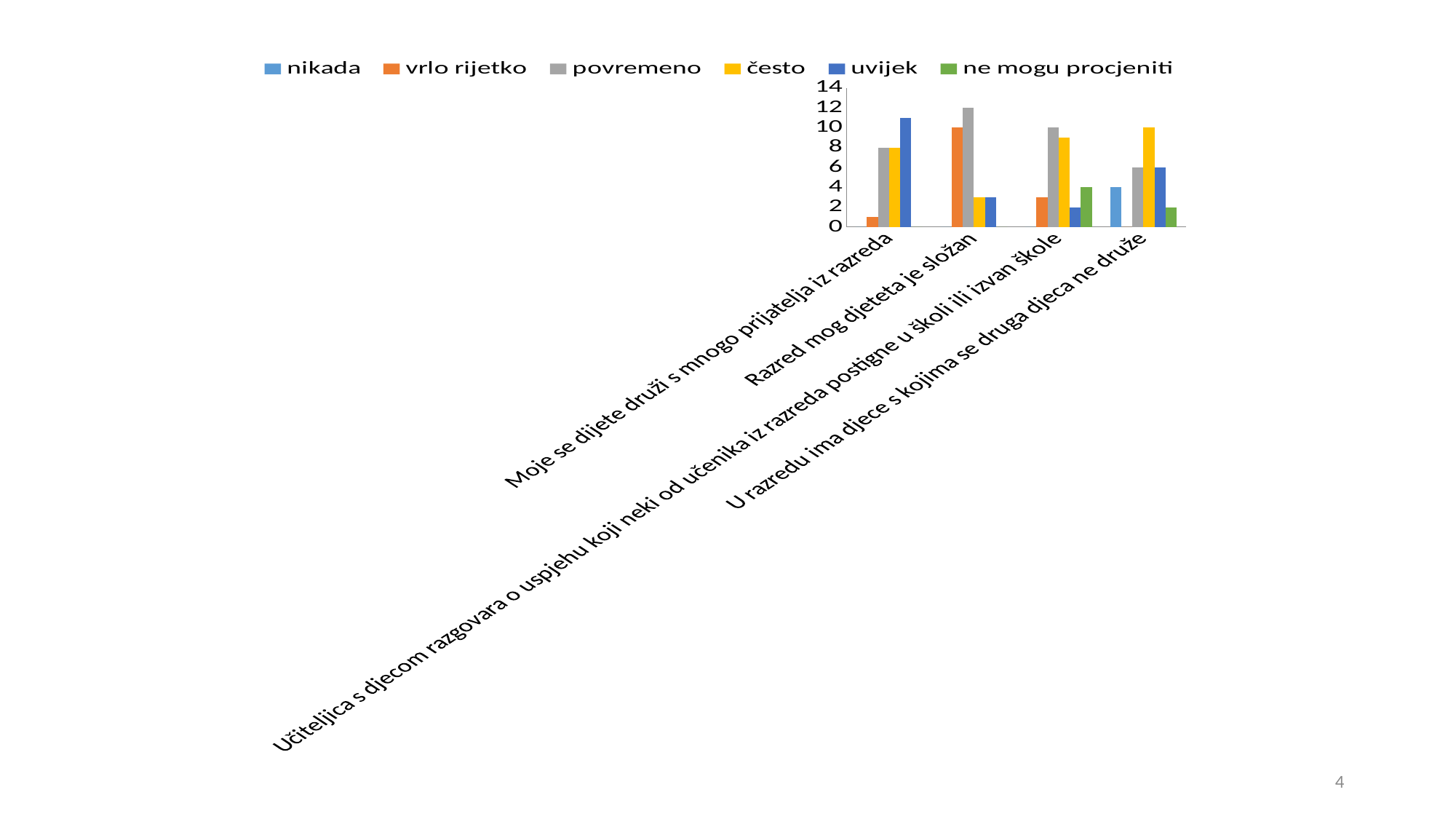
How many series does the legend list? 6 Is the value of "uvijek" for "Učiteljica s djecom razgovara o uspjehu koji neki od učenika iz razreda postigne u školi ili izvan škole" greater or less than 4? less Is the value of "povremeno" for "Razred mog djeteta je složan" greater or less than 10? greater For "Razred mog djeteta je složan", which is larger: "vrlo rijetko" or "često"? vrlo rijetko Which series has the highest value for "Moje se dijete druži s mnogo prijatelja iz razreda"? uvijek How many categories are shown on the x axis? 4 For "U razredu ima djece s kojima se druga djeca ne druže", which is larger: "često" or "nikada"? često Which series has the highest value for "Razred mog djeteta je složan"? povremeno What kind of chart is shown on the slide? bar chart Which series has the highest value for "U razredu ima djece s kojima se druga djeca ne druže"? često What is the last entry in the chart's legend? ne mogu procjeniti